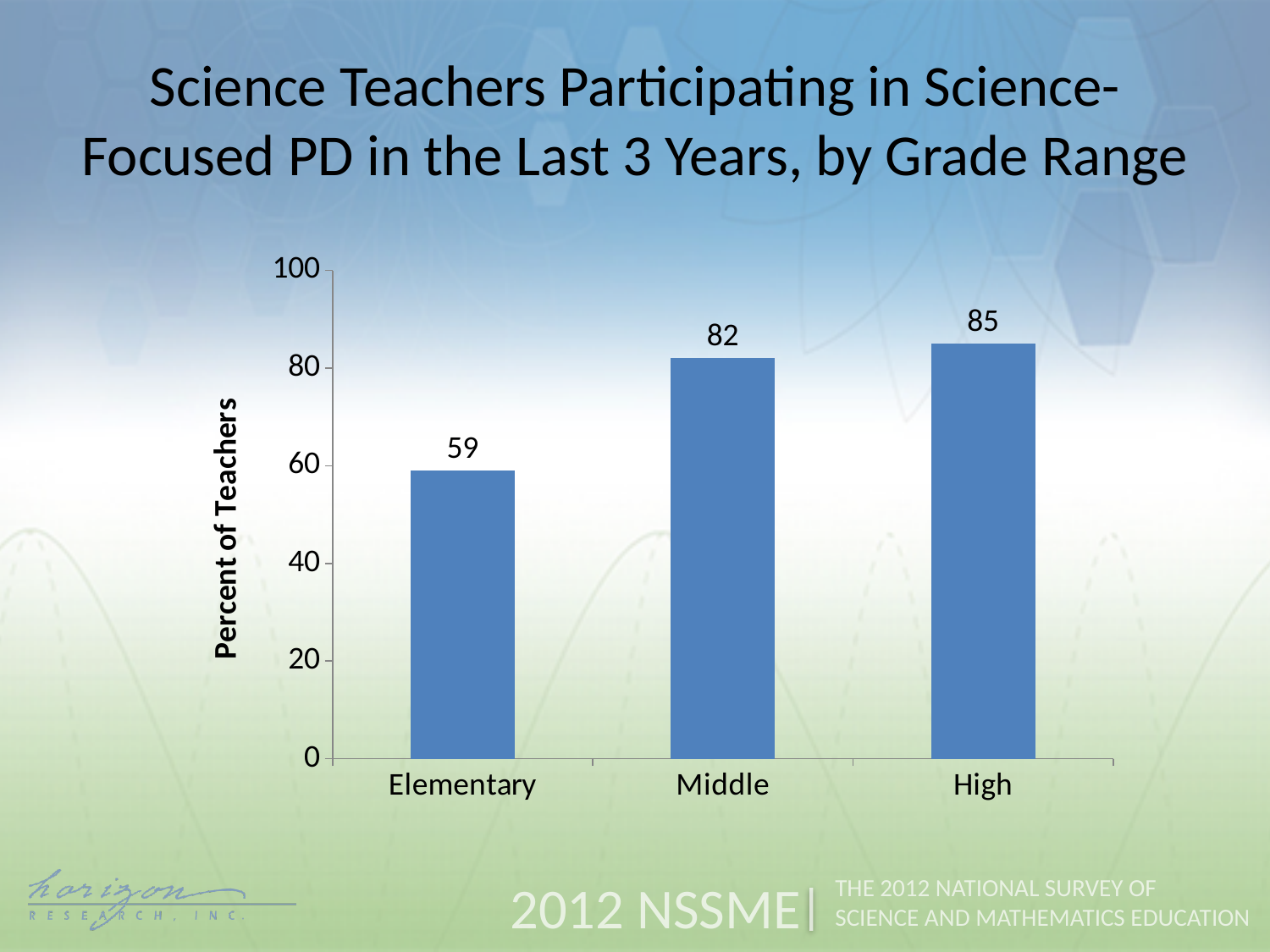
What is the difference between the values for High and Elementary? 26 What is the label of the vertical axis? Percent of Teachers What is the value for Elementary? 59 What is the value for Middle? 82 Which grade range has the highest percent of teachers? High Which grade range has the lowest percent of teachers? Elementary Which is larger, the value for Elementary or the value for Middle? Middle How many grade ranges are shown on the chart? 3 What kind of chart is shown on the slide? bar chart Is the value for Elementary greater or less than 60? less What is the value for High? 85 What is the difference between the values for Middle and Elementary? 23